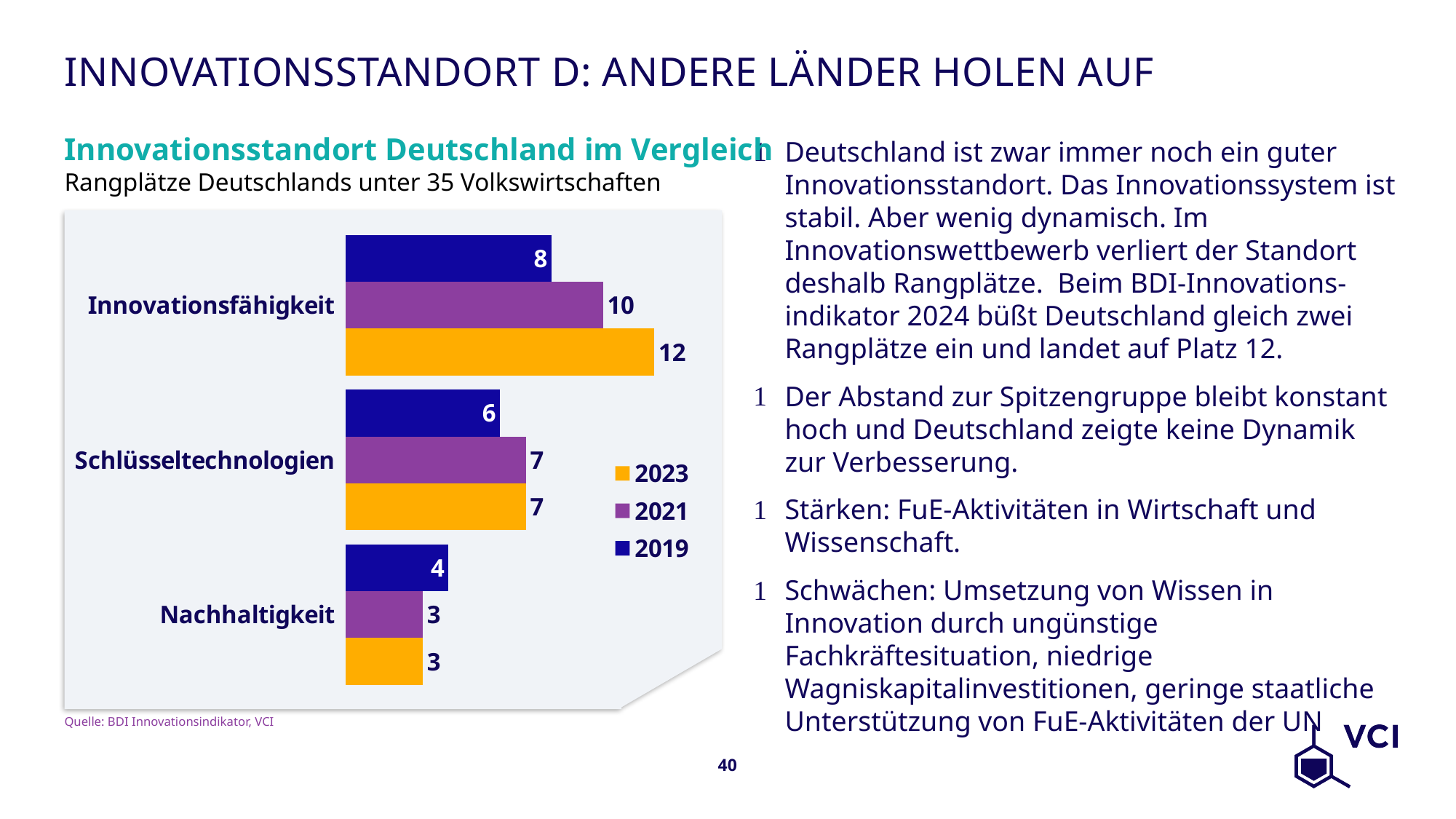
Which category has the highest 2023 value? Innovationsfähigkeit How many categories are shown in the chart? 3 How many series does the legend list? 3 What is the title of the chart? Innovationsstandort Deutschland im Vergleich What is the 2021 value for Innovationsfähigkeit? 10 What is the 2023 value for Innovationsfähigkeit? 12 Which category has the lowest 2019 value? Nachhaltigkeit What is the 2019 value for Schlüsseltechnologien? 6 What kind of chart is shown on the slide? Bar chart Which is larger for Nachhaltigkeit: the 2019 value or the 2023 value? 2019 What is the 2021 value for Nachhaltigkeit? 3 What is the difference between the 2023 and 2019 values for Innovationsfähigkeit? 4